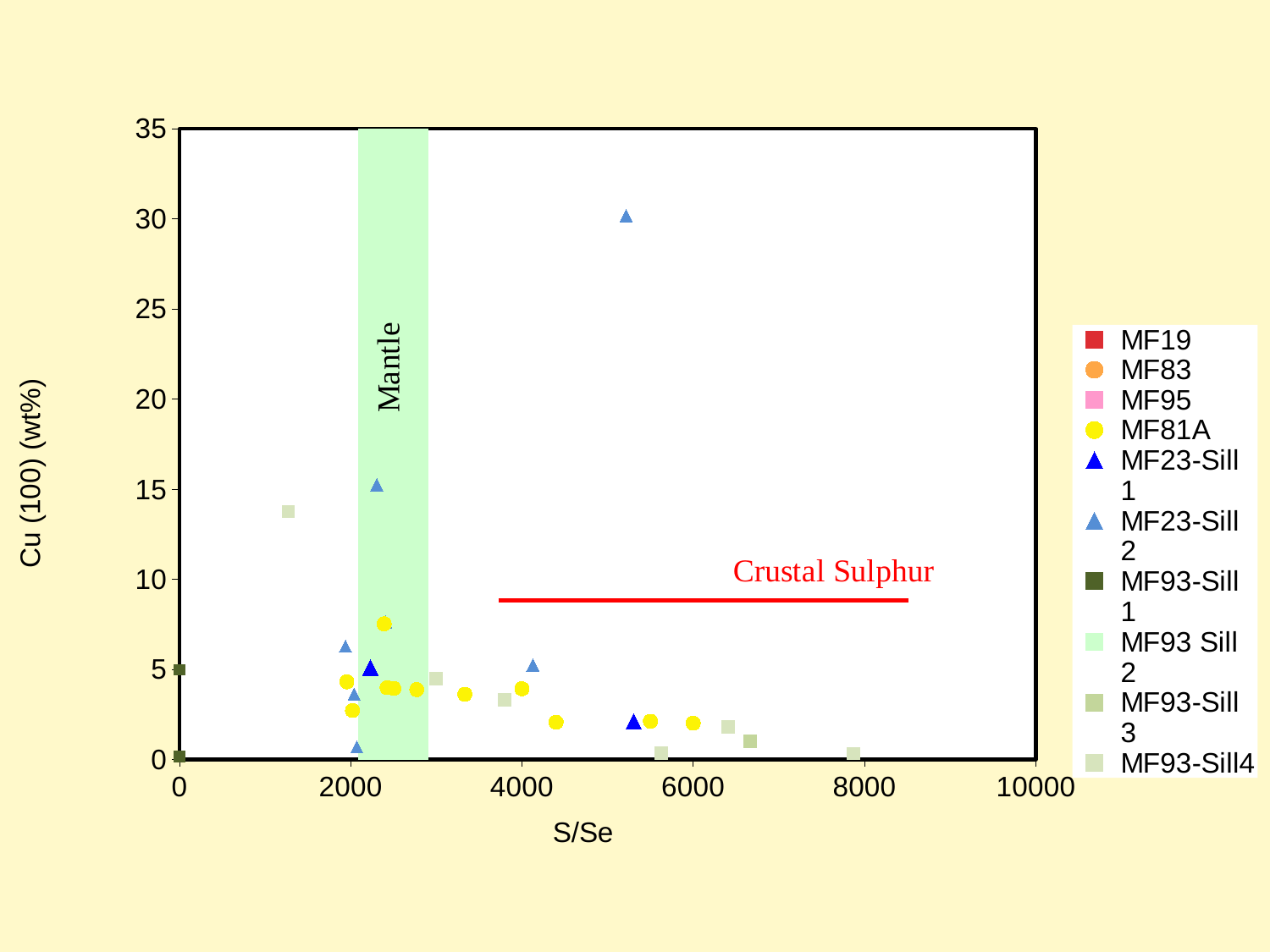
What is the highest tick value shown on the x axis? 10000 What is the highest tick value shown on the y axis? 35 Is the MF93-Sill4 point plotted near S/Se = 1250 greater or less than 10 on the y axis? greater What kind of chart is shown on the slide? scatter chart What is the label of the y axis? Cu (100) (wt%) How many series does the legend list? 10 Which series has the highest plotted point on the chart? MF23-Sill 2 Is the highest plotted point for MF23-Sill 2 greater or less than 25? greater Are all the MF81A points plotted below 10 on the y axis? yes